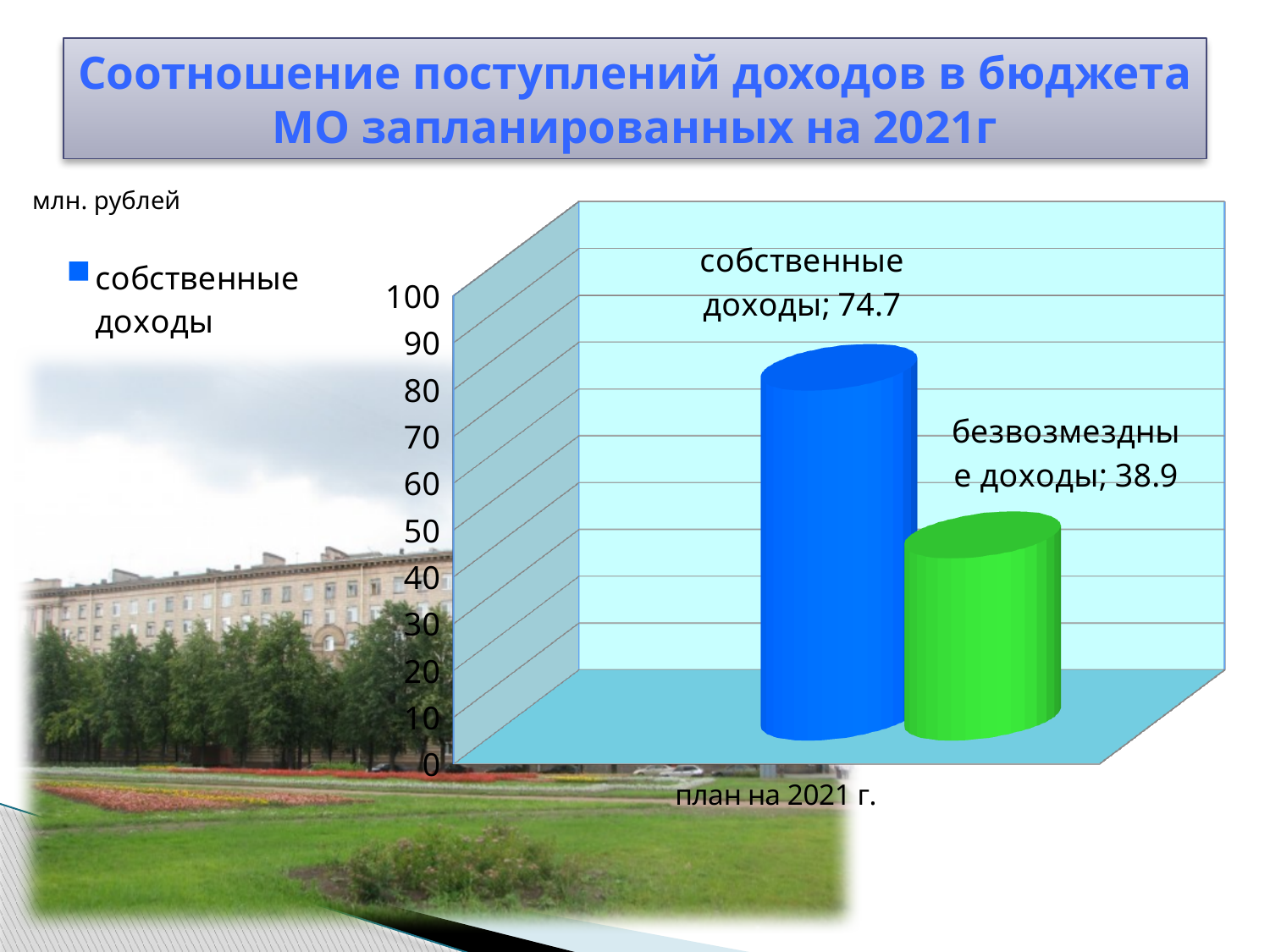
What kind of chart is shown on the slide? bar chart What is the value for безвозмездные доходы? 38.9 What is the total of собственные доходы and безвозмездные доходы? 113.6 Is the value for собственные доходы greater or less than 70? greater Is the value for безвозмездные доходы larger or smaller than the value for собственные доходы? smaller Which series has the lower value? безвозмездные доходы Which series has the higher value, собственные доходы or безвозмездные доходы? собственные доходы Is the value for безвозмездные доходы greater or less than 40? less What is the value for собственные доходы? 74.7 What is the highest value shown on the vertical axis? 100 What is the difference between собственные доходы and безвозмездные доходы? 35.8 What is the category label on the x axis? план на 2021 г.